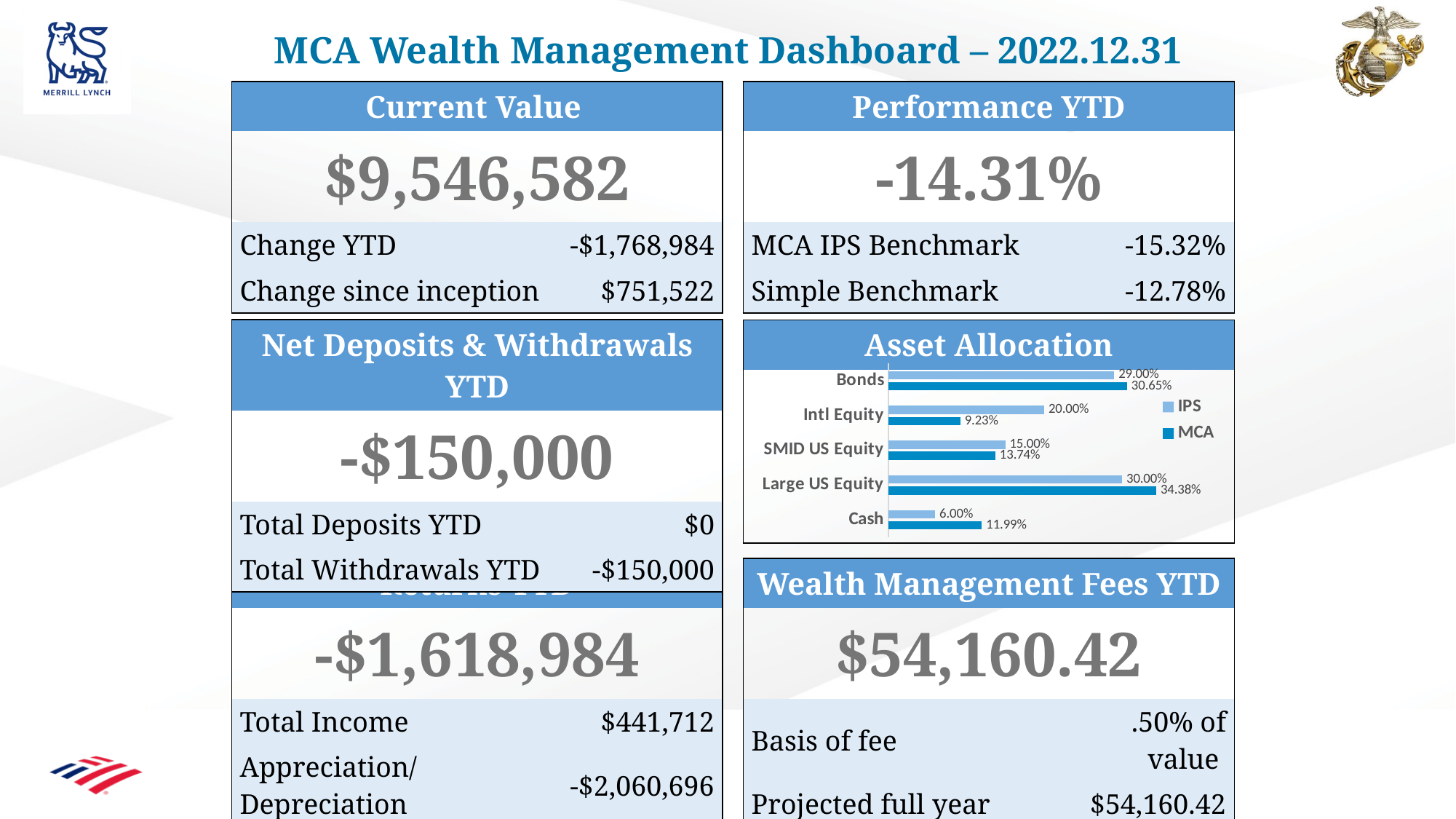
In the Asset Allocation chart, what is the MCA value for Cash? 11.99% In the Asset Allocation chart, which series is shown in the darker blue colour? MCA In the Asset Allocation chart, what is the difference between the IPS and MCA values for Intl Equity? 10.77% In the Asset Allocation chart, how many asset categories are shown? 5 In the Asset Allocation chart, what is the MCA value for Bonds? 30.65% What type of chart is shown in the Asset Allocation panel? bar chart In the Asset Allocation chart, what is the IPS value for Intl Equity? 20.00% In the Asset Allocation chart, which is larger for Large US Equity, the IPS value or the MCA value? MCA In the Asset Allocation chart, which category has the lowest IPS value? Cash In the Asset Allocation chart, what is the IPS value for SMID US Equity? 15.00% In the Asset Allocation chart, which category has the highest MCA value? Large US Equity In the Asset Allocation chart, how many series does the legend list? 2